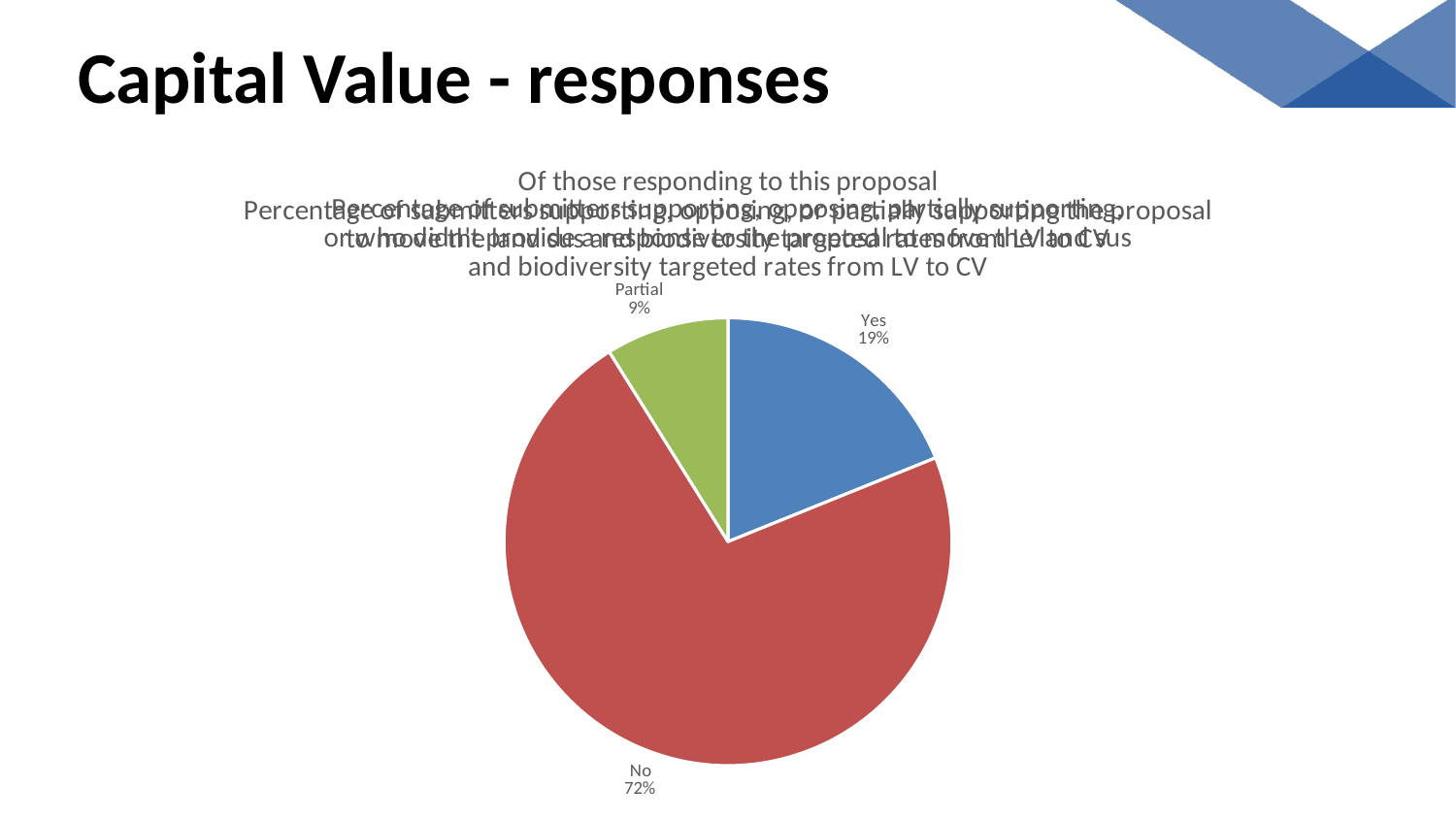
What is the difference in percentage points between the "Yes" share and the "Partial" share? 10 How many slices does the pie chart have? 3 What colour is the "Partial" slice of the pie chart? green What is the difference in percentage points between the "No" share and the "Yes" share? 53 Which response category has the smallest share of the pie? Partial What percentage of responses are "Partial"? 9% What percentage of responses are "Yes"? 19% What kind of chart is shown on the slide? pie chart Which is larger, the "Yes" share or the "Partial" share? Yes What colour is the "No" slice of the pie chart? red Which response category has the largest share of the pie? No What percentage of responses are "No"? 72%